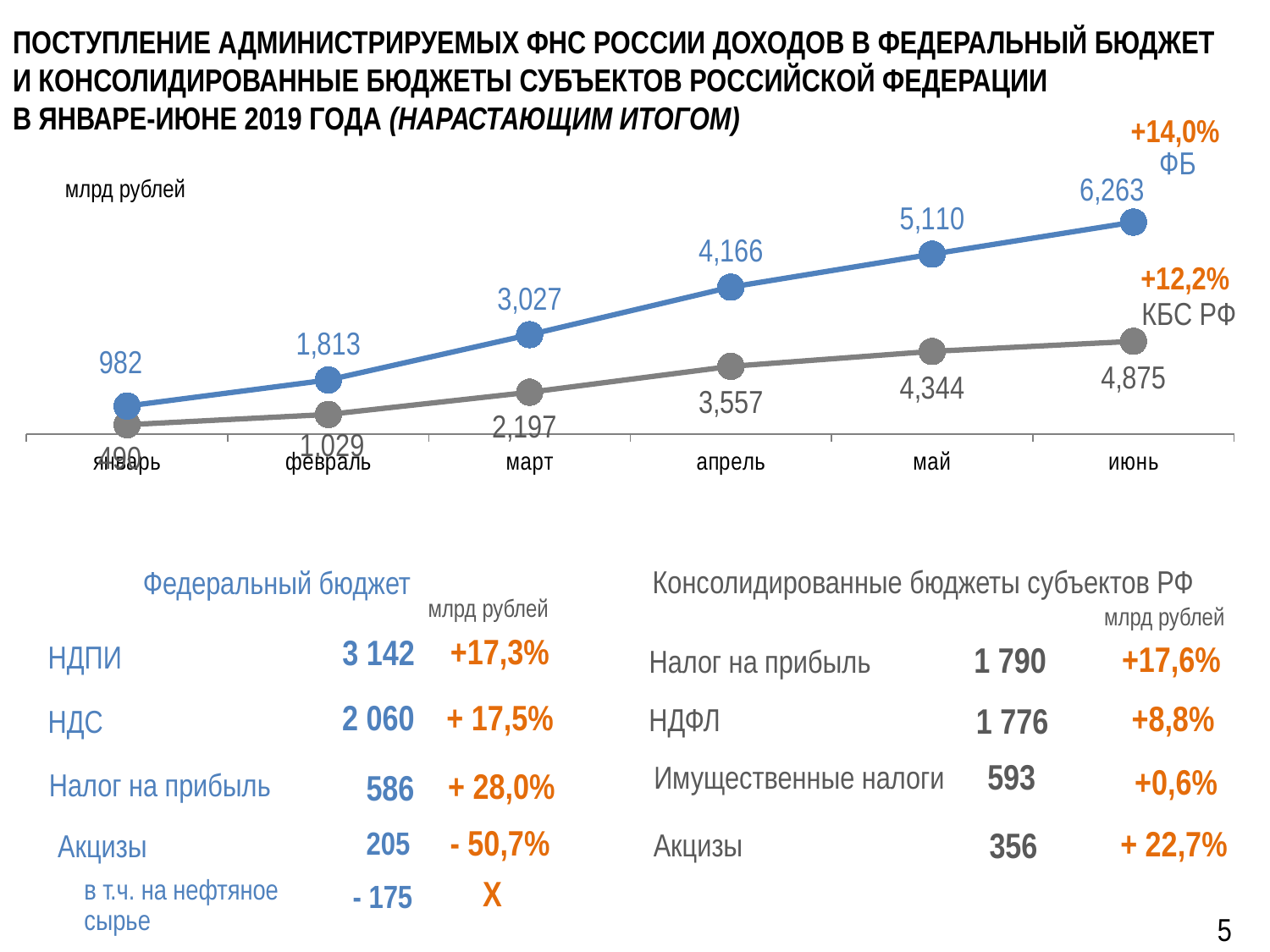
Which is larger in февраль, ФБ or КБС РФ? ФБ What is the value for ФБ in март? 3,027 What is the value for ФБ in июнь? 6,263 What is the value for КБС РФ in май? 4,344 What is the value for КБС РФ in апрель? 3,557 In which month is the ФБ series at its lowest? январь What is the difference between the ФБ values in май and апрель? 944 What kind of chart is shown on the slide? line chart What is the difference between ФБ and КБС РФ in июнь? 1,388 In which month is the ФБ series at its highest? июнь How many months are plotted on the x axis? 6 Do the КБС РФ values rise or fall from январь to июнь? rise